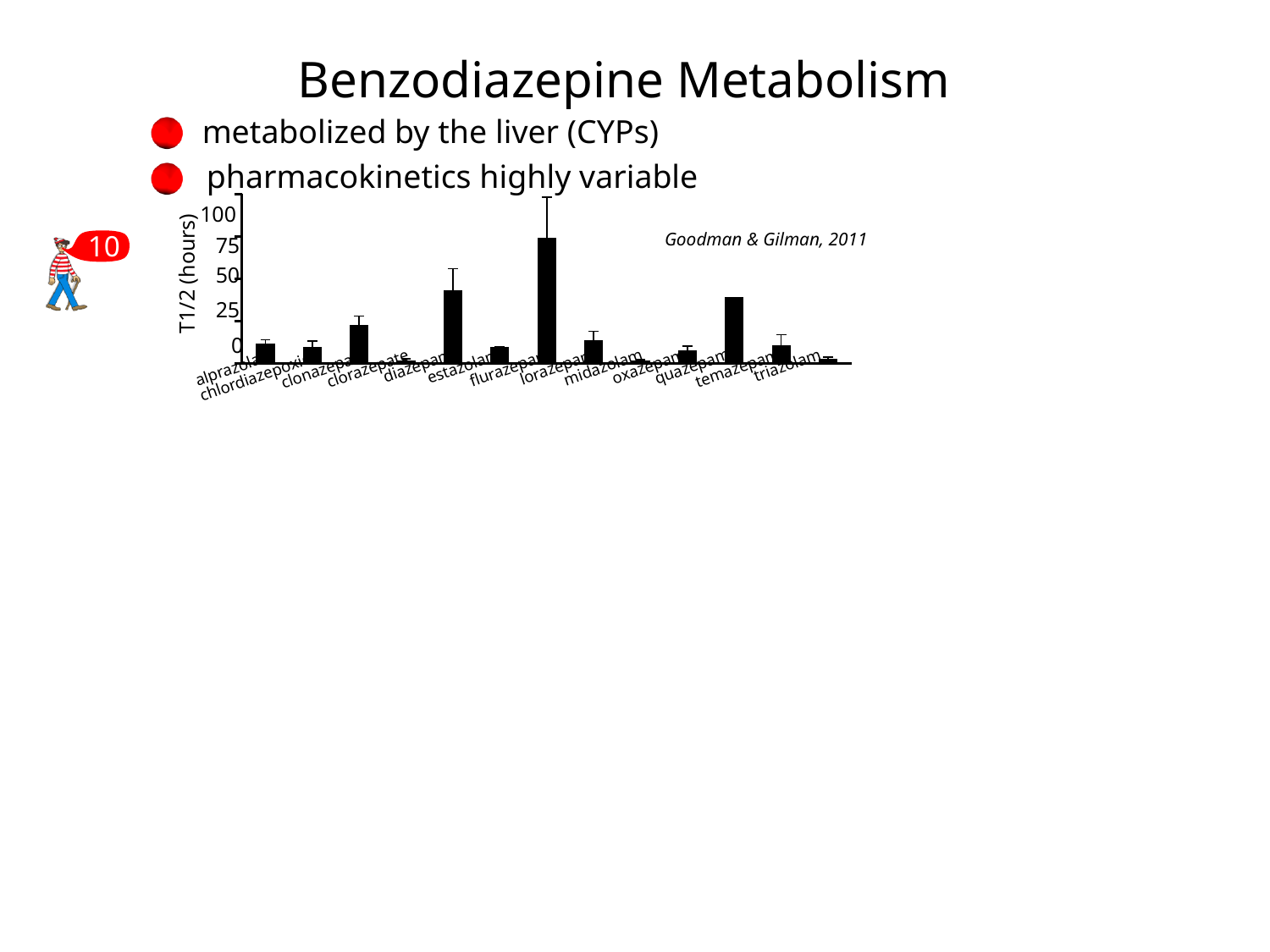
Is the T1/2 value for quazepam greater or less than 25 hours? greater Which drug has the highest T1/2 (hours) value in the chart? flurazepam What kind of chart is shown on the slide? bar chart Is the T1/2 value for diazepam greater or less than 25 hours? greater Is the T1/2 value for alprazolam greater or less than 25 hours? less Which has a larger T1/2 value, flurazepam or diazepam? flurazepam What source is cited next to the chart? Goodman & Gilman, 2011 Which has a larger T1/2 value, clonazepam or alprazolam? clonazepam What is the label on the vertical axis of the chart? T1/2 (hours)